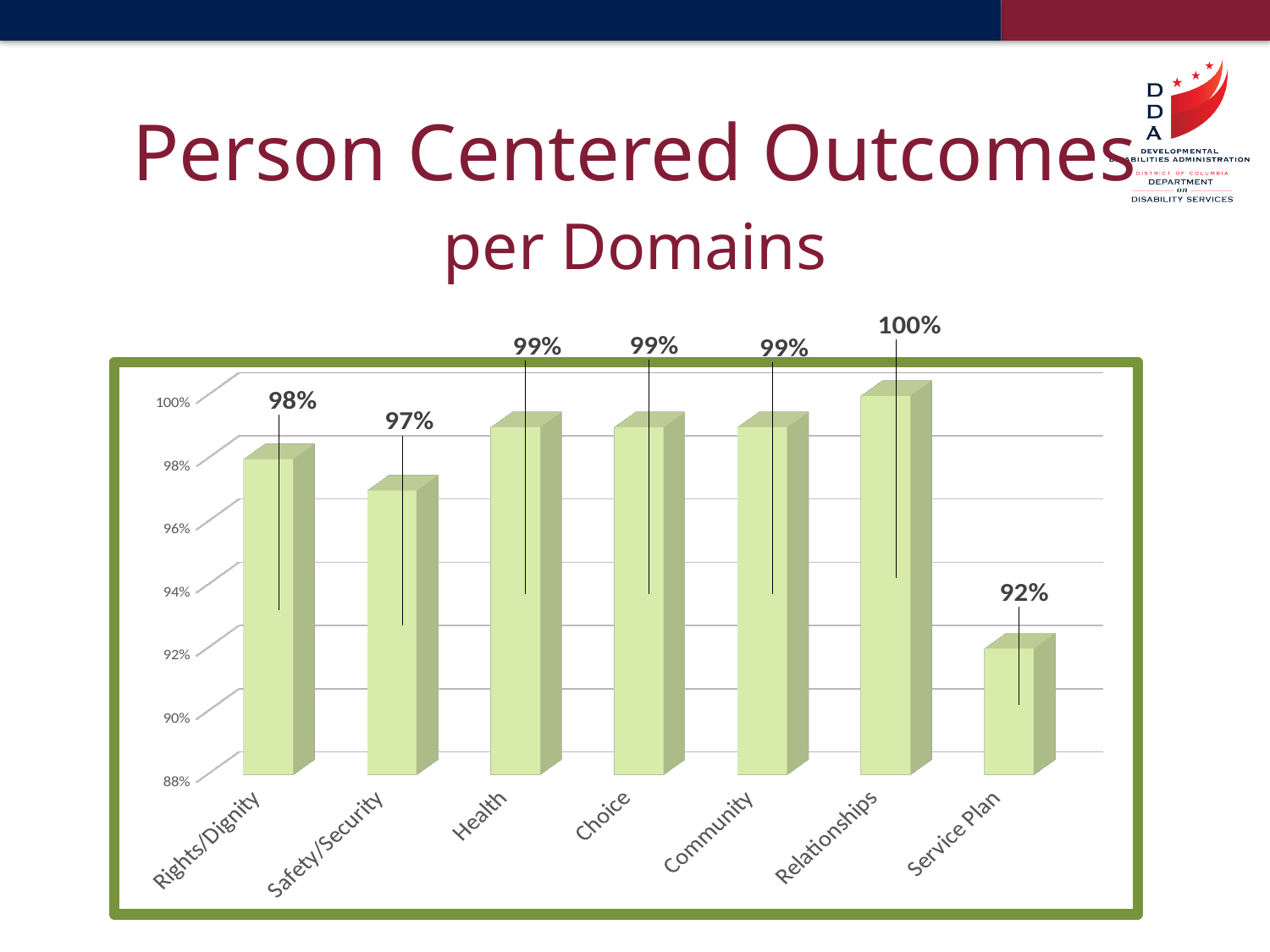
How many domains are shown on the chart? 7 What is the value for Rights/Dignity? 98% Which is larger, the value for Health or the value for Safety/Security? Health Which domain has the highest value? Relationships What is the difference between the values for Relationships and Service Plan? 8% What is the value for Service Plan? 92% What kind of chart is shown on the slide? Bar chart What is the value for Relationships? 100% What is the difference between the values for Rights/Dignity and Safety/Security? 1% Which domain has the lowest value? Service Plan What is the value for Safety/Security? 97% What is the title of the slide containing the chart? Person Centered Outcomes per Domains